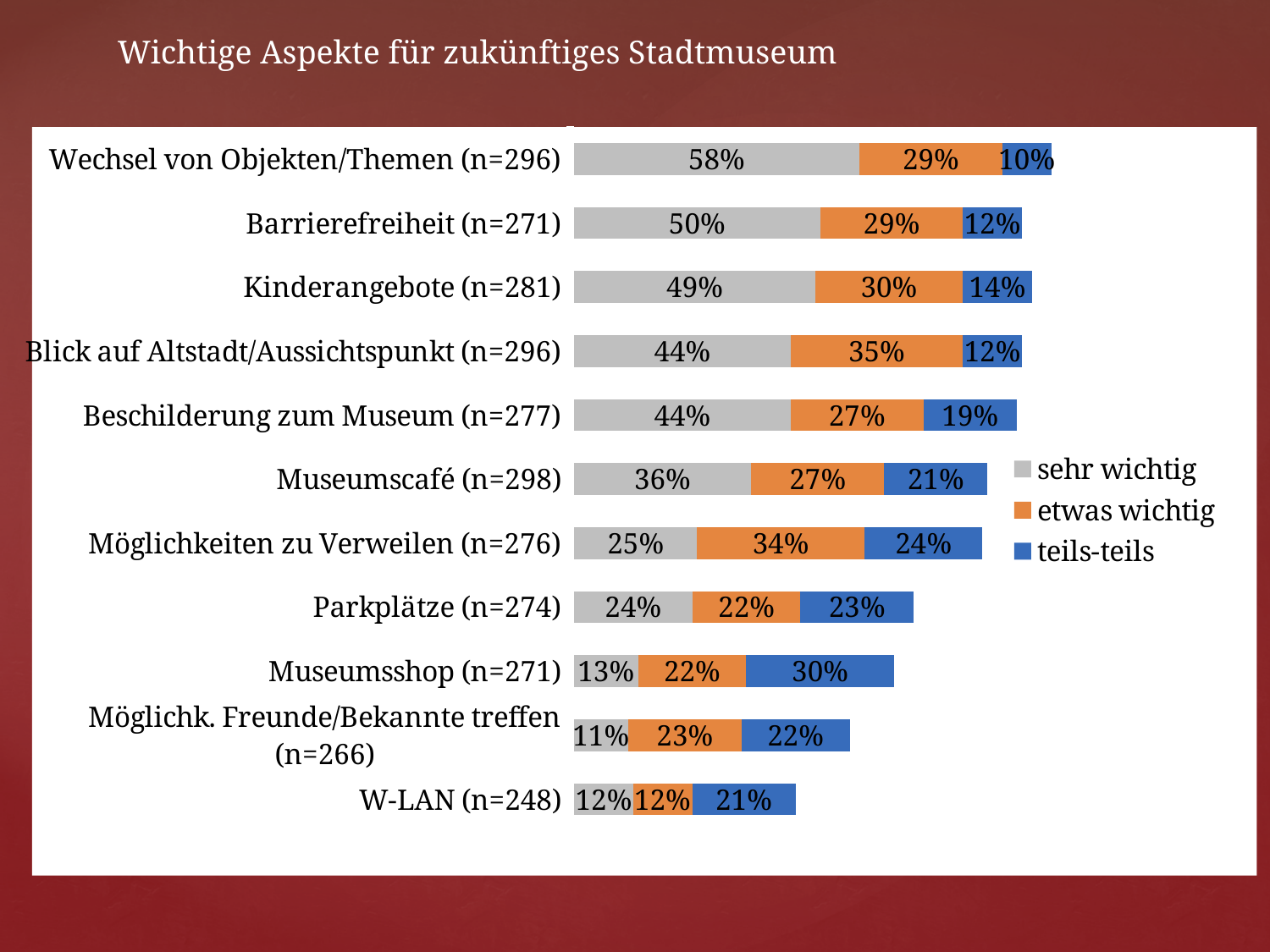
Which colour represents 'etwas wichtig' in the legend? Orange How many categories are shown in the chart? 11 Which category has the highest 'sehr wichtig' value? Wechsel von Objekten/Themen (n=296) What kind of chart is shown on the slide? Stacked bar chart What is the 'teils-teils' value for Museumsshop (n=271)? 30% Which category has the lowest 'sehr wichtig' value? Möglichk. Freunde/Bekannte treffen (n=266) What is the total of the three segments for W-LAN (n=248)? 45% What is the 'sehr wichtig' value for Wechsel von Objekten/Themen (n=296)? 58% Which is larger: the 'teils-teils' value for Beschilderung zum Museum (n=277) or for Kinderangebote (n=281)? Beschilderung zum Museum (n=277) How many series does the legend list? 3 What is the 'etwas wichtig' value for Blick auf Altstadt/Aussichtspunkt (n=296)? 35% What is the difference between the 'sehr wichtig' values for Barrierefreiheit (n=271) and Museumscafé (n=298)? 14%